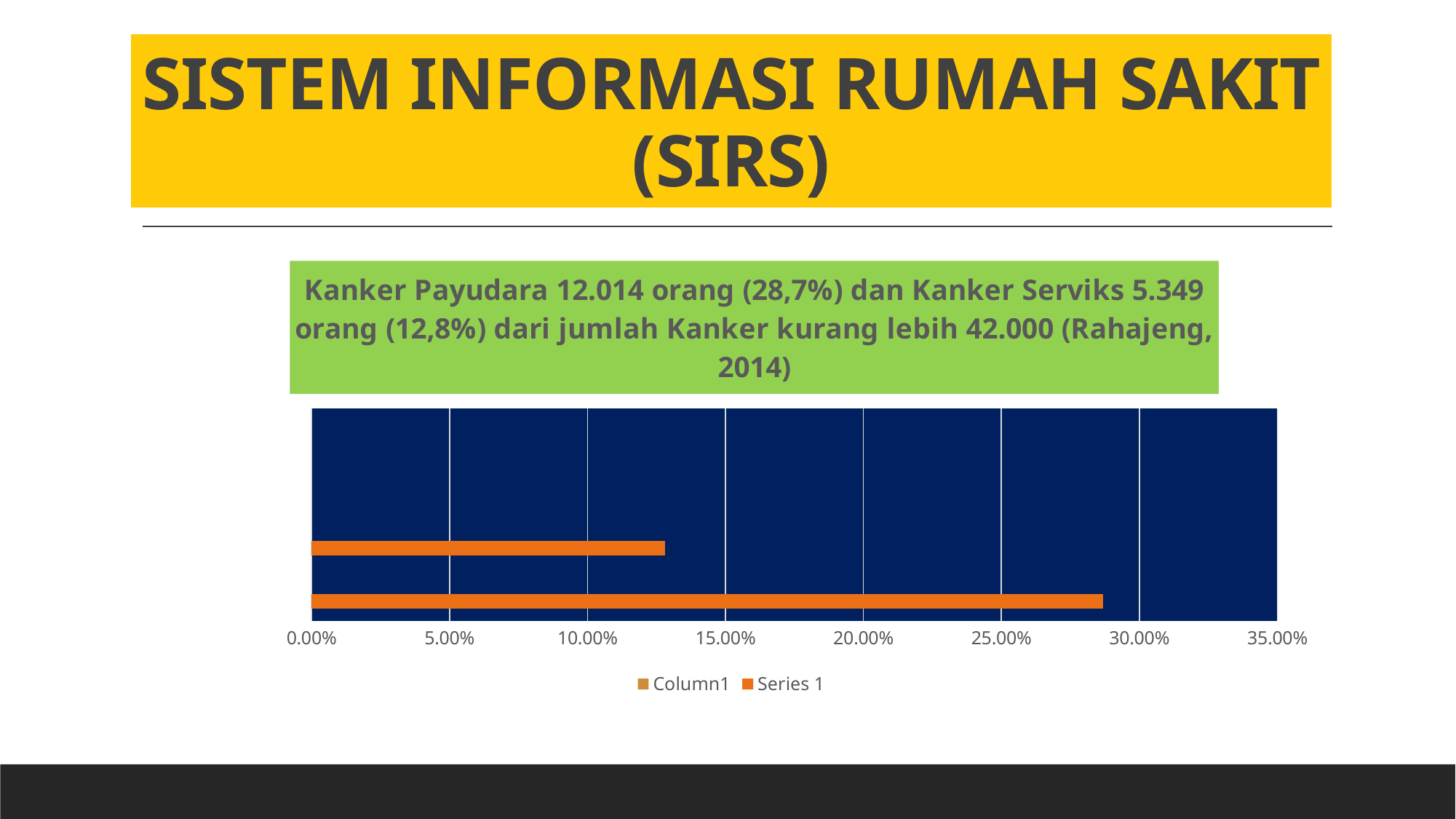
Is the value of the top bar greater or less than 10.00%? greater Is the value of the bottom bar greater or less than 30.00%? less Which bar is longer, the top bar or the bottom bar? the bottom bar Is the value of the bottom bar greater or less than 25.00%? greater What is the highest value shown on the chart's horizontal axis? 35.00% How many series does the chart legend list? 2 What are the two entries listed in the chart legend? Column1 and Series 1 How many bars are plotted in the chart? 2 What kind of chart is shown on the slide? bar chart